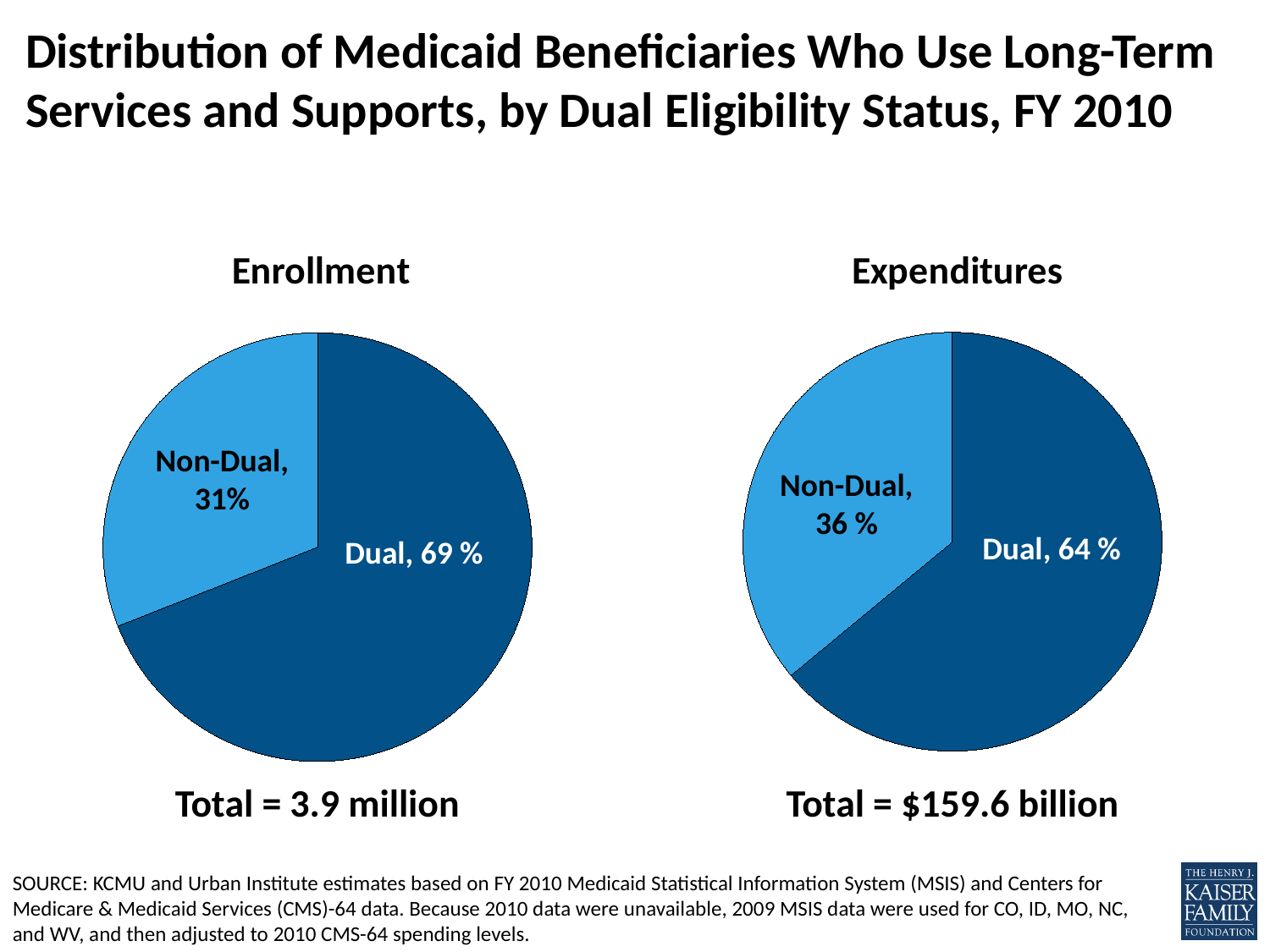
What kind of chart is used for Enrollment? Pie chart In the Expenditures pie chart, what share of expenditures is Non-Dual? 36 % What is the total shown below the Expenditures pie chart? Total = $159.6 billion In the Enrollment pie chart, what share of beneficiaries are Dual? 69 % Is the Non-Dual share larger in the Enrollment chart or the Expenditures chart? Expenditures In the Expenditures pie chart, which slice is the smallest? Non-Dual How many slices does the Expenditures pie chart have? 2 What is the total shown below the Enrollment pie chart? Total = 3.9 million In the Enrollment pie chart, what share of beneficiaries are Non-Dual? 31% In the Enrollment pie chart, which slice is the largest? Dual In the Enrollment pie chart, what is the difference in percentage points between the Dual and Non-Dual shares? 38 percentage points In the Expenditures pie chart, what share of expenditures is Dual? 64 %